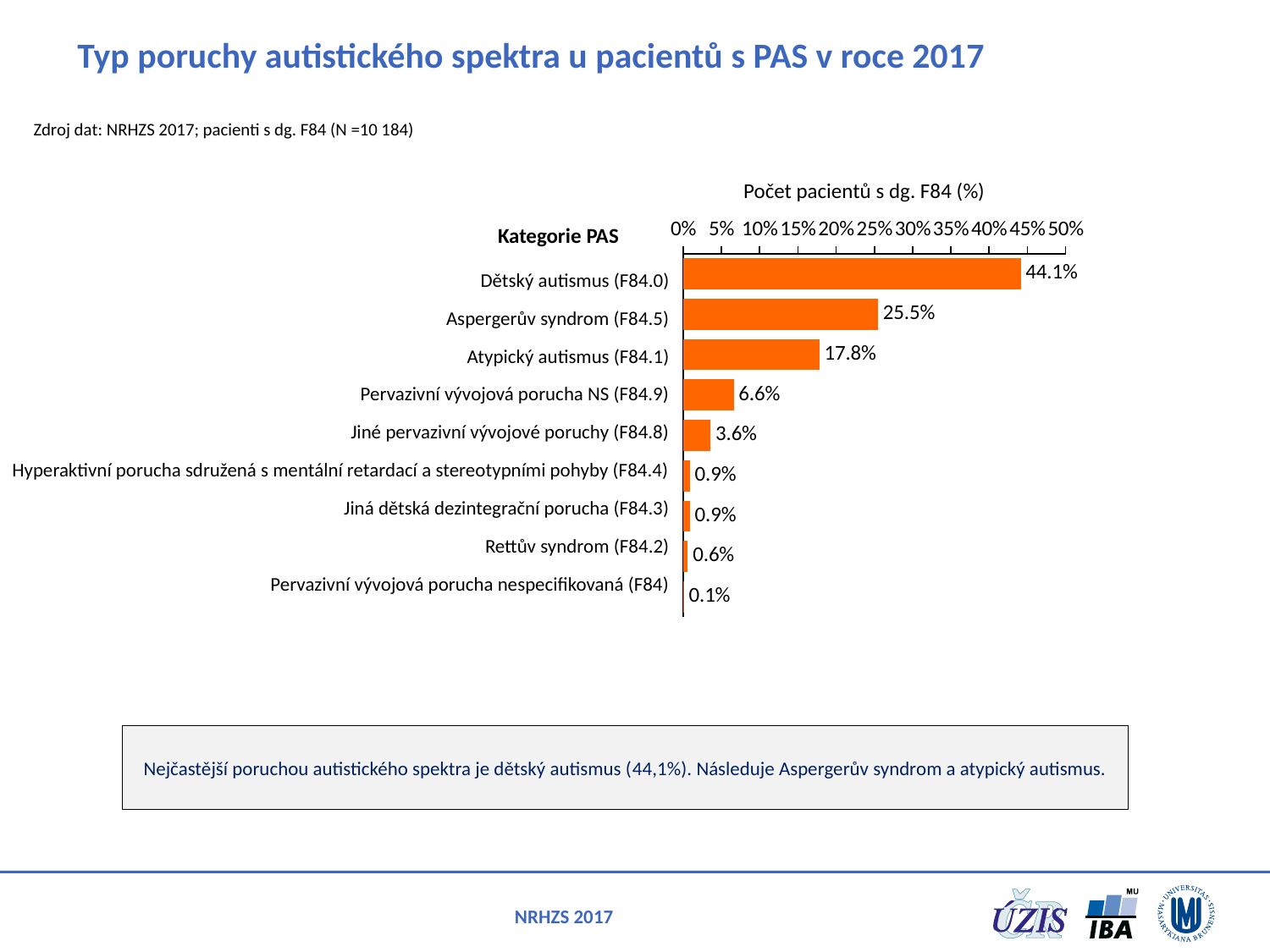
What is the value for Aspergerův syndrom (F84.5)? 25.5% Which category has the highest value? Dětský autismus (F84.0) Which category has the lowest value? Pervazivní vývojová porucha nespecifikovaná (F84) What is the value for Dětský autismus (F84.0)? 44.1% Is the value for Aspergerův syndrom (F84.5) greater or less than 20%? greater What is the title of the chart's value axis? Počet pacientů s dg. F84 (%) What is the value for Pervazivní vývojová porucha NS (F84.9)? 6.6% How many categories are shown in the chart? 9 Which is larger, the value for Atypický autismus (F84.1) or the value for Jiné pervazivní vývojové poruchy (F84.8)? Atypický autismus (F84.1) What is the difference between the values for Dětský autismus (F84.0) and Aspergerův syndrom (F84.5)? 18.6% What is the value for Rettův syndrom (F84.2)? 0.6% What kind of chart is shown on the slide? bar chart